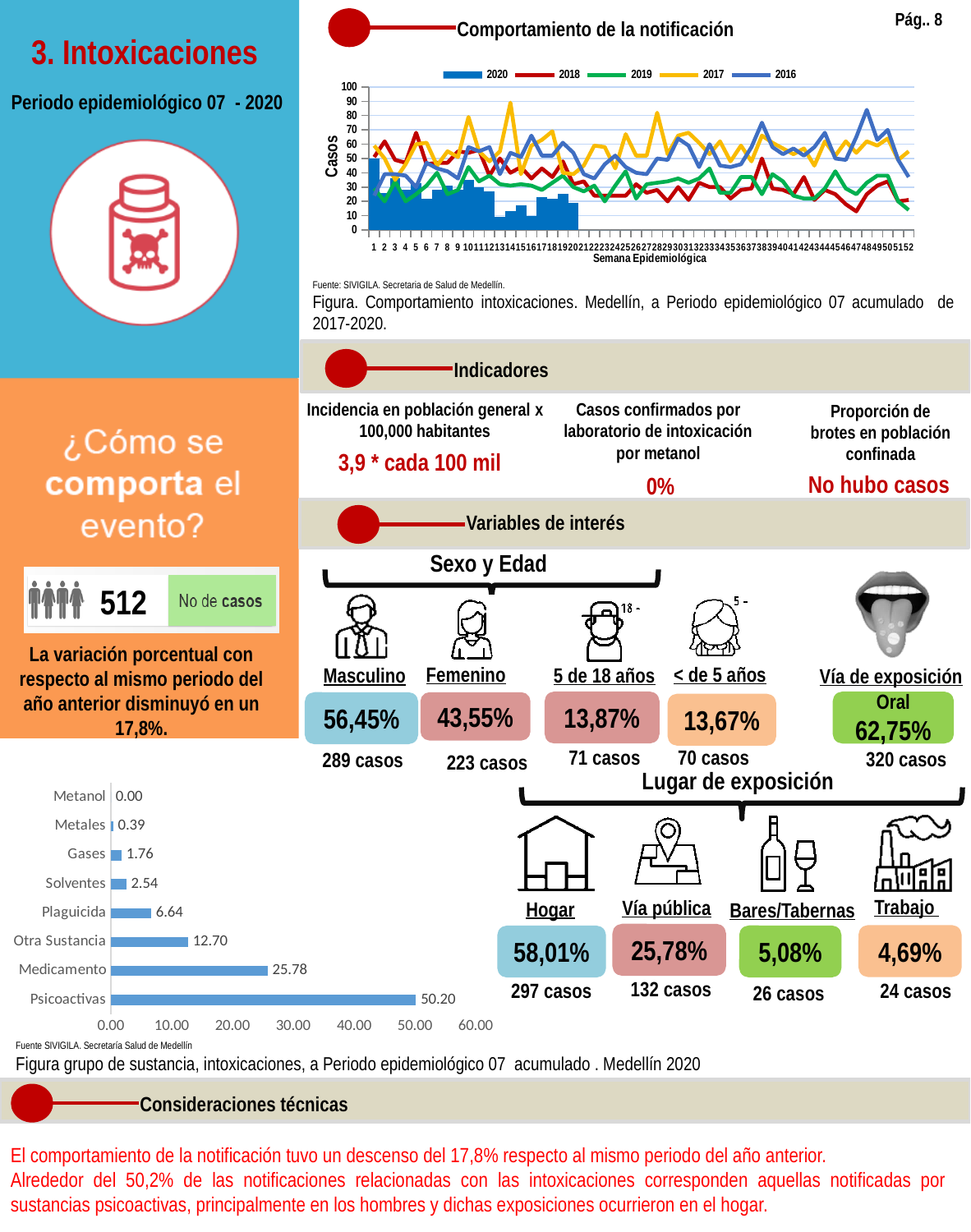
In the bottom bar chart on substance groups, which category has the lowest value? Metanol In the bottom bar chart on substance groups, what is the value for Plaguicida? 6.64 In the bottom bar chart on substance groups, which category has the highest value? Psicoactivas In the 'Comportamiento de la notificación' chart, is the value for 2017 at week 14 greater or less than 80? greater In the bottom bar chart on substance groups, what is the value for Psicoactivas? 50.20 What kind of chart is the bottom chart on substance groups? Bar chart What is the label of the y axis in the 'Comportamiento de la notificación' chart? Casos In the bottom bar chart on substance groups, which is larger: Gases or Solventes? Solventes How many categories are shown in the bottom bar chart on substance groups? 8 How many series does the legend of the 'Comportamiento de la notificación' chart list? 5 In the bottom bar chart on substance groups, what is the difference between Psicoactivas and Medicamento? 24.42 In the bottom bar chart on substance groups, what is the value for Medicamento? 25.78